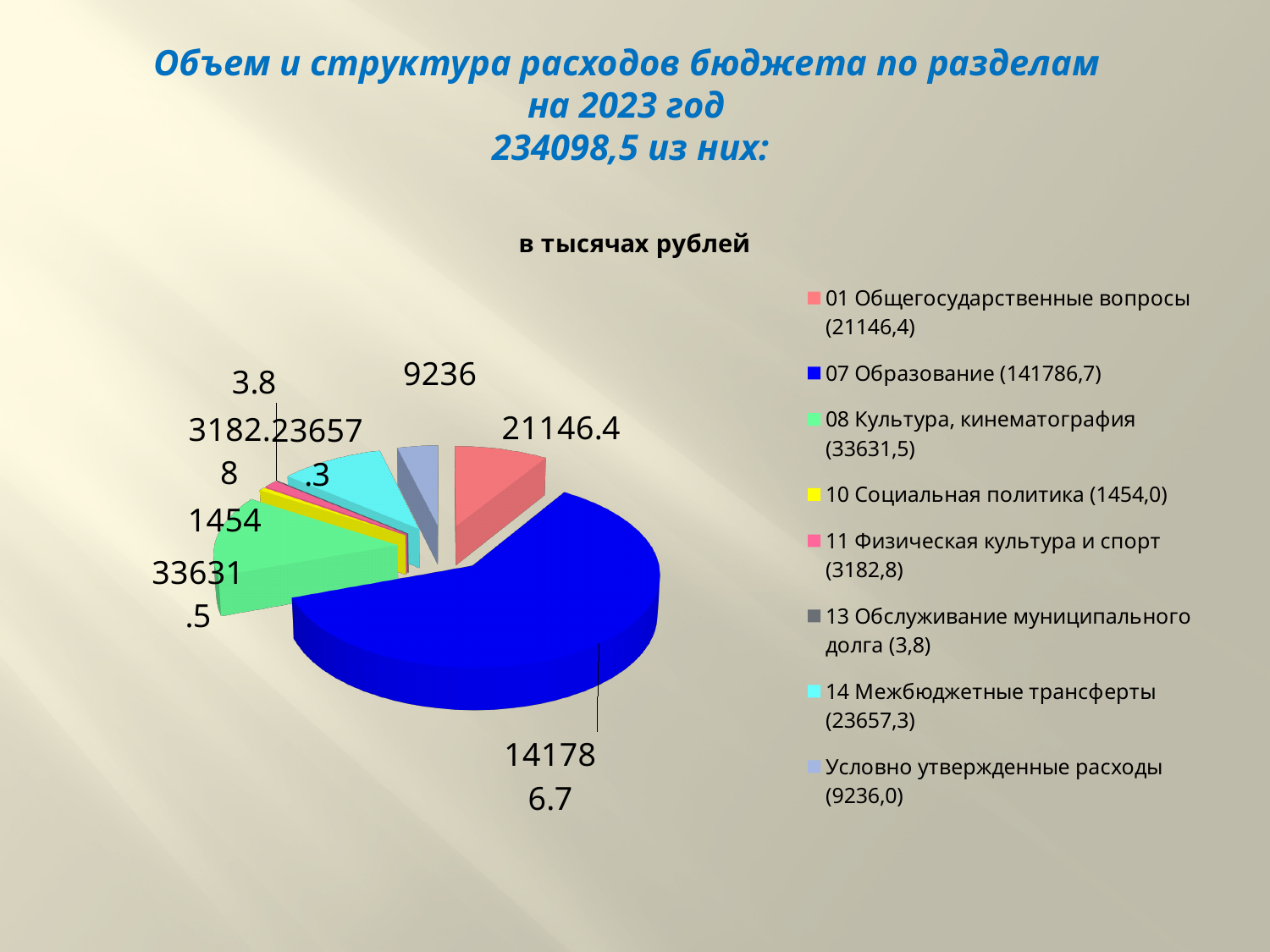
What is the difference between the values for 08 Культура, кинематография and 14 Межбюджетные трансферты? 9974.2 What is the difference between the values for 07 Образование and 01 Общегосударственные вопросы? 120640.3 Which category has the smallest slice of the pie? 13 Обслуживание муниципального долга What is the value shown for 01 Общегосударственные вопросы? 21146.4 What is the value shown for 13 Обслуживание муниципального долга? 3.8 What is the value shown for 14 Межбюджетные трансферты? 23657.3 Which is larger: the value for Условно утвержденные расходы or the value for 11 Физическая культура и спорт? Условно утвержденные расходы How many slices does the pie chart have? 8 What is the title printed above the pie chart? в тысячах рублей Which category has the largest slice of the pie? 07 Образование What is the value shown for 07 Образование? 141786.7 What type of chart is shown on the slide? pie chart